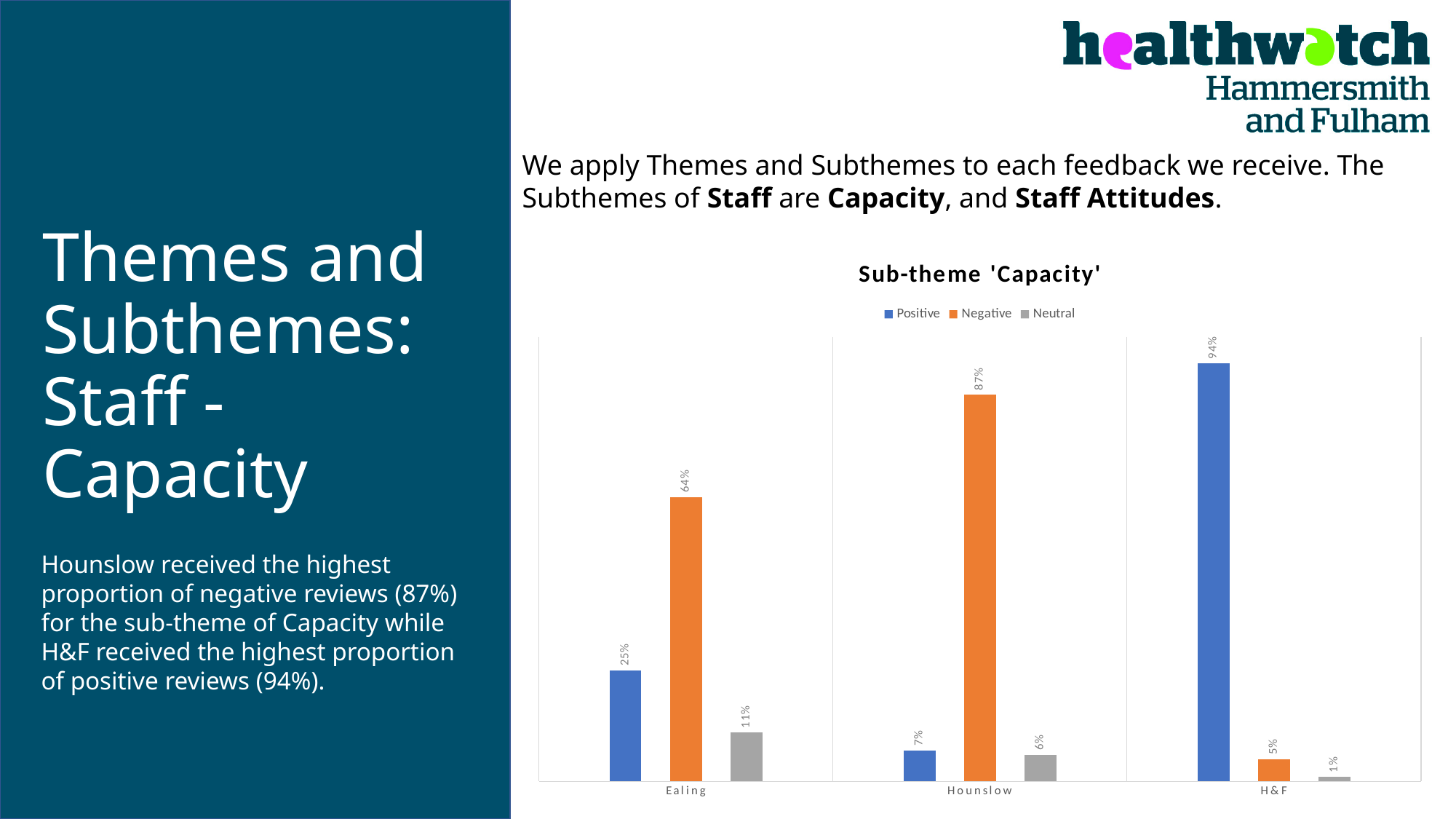
How many series does the legend list? 3 What is the Negative value for Hounslow? 87% What is the Positive value for H&F? 94% What is the difference between the Negative values for Hounslow and Ealing? 23% What is the Neutral value for Ealing? 11% What is the title of the chart? Sub-theme 'Capacity' How many categories are shown on the x axis? 3 Which category has the highest Negative value? Hounslow What is the Positive value for Ealing? 25% Which category has the lowest Neutral value? H&F What kind of chart is shown? Bar chart Which is larger, the Positive value for Ealing or the Positive value for Hounslow? Ealing